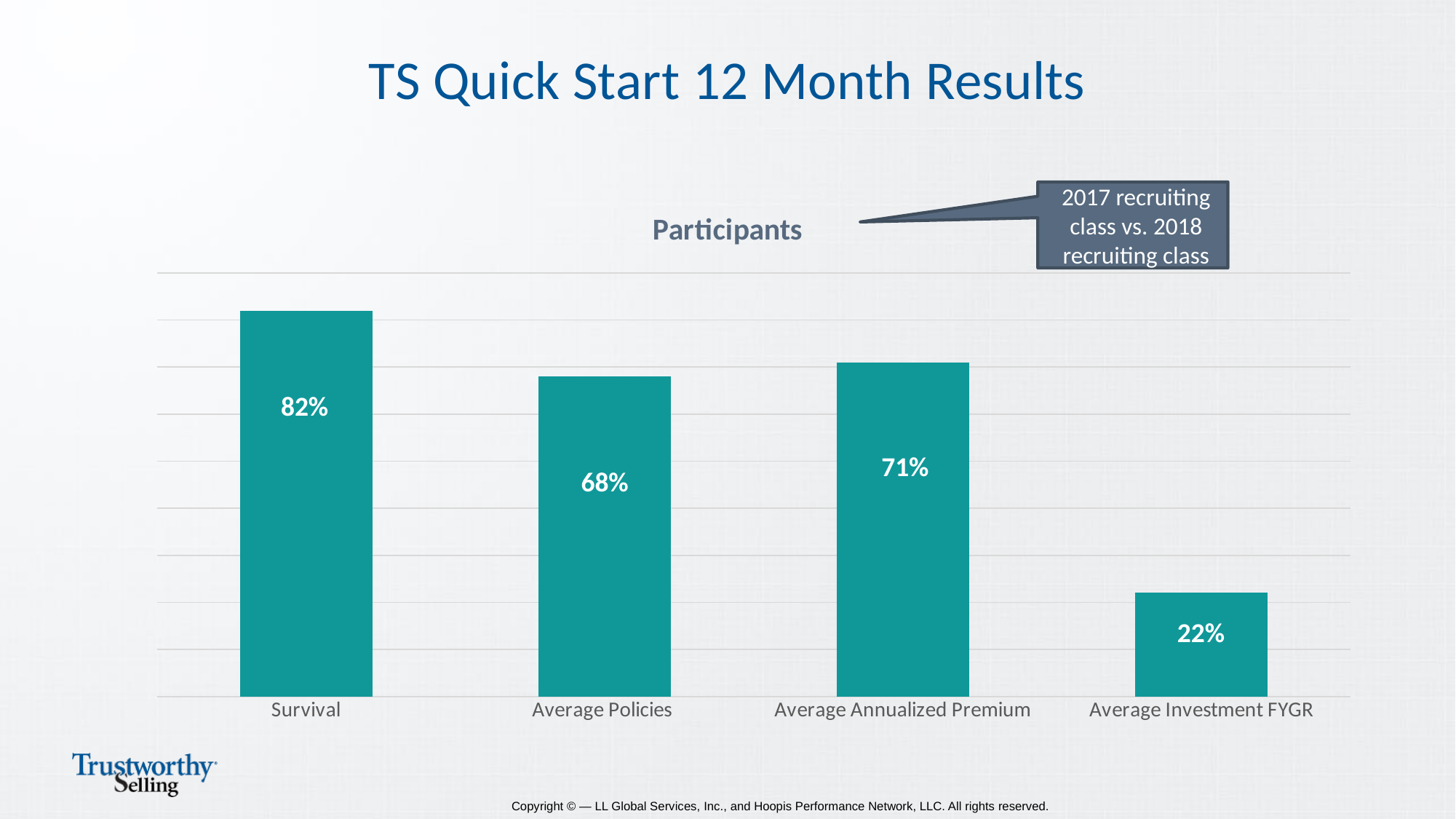
Which is larger, the value for Average Policies or the value for Average Annualized Premium? Average Annualized Premium What is the difference between the values for Average Annualized Premium and Average Policies? 3% Which category has the highest value? Survival What is the title of the chart? Participants What kind of chart is shown on the slide? Bar chart What is the value for Survival? 82% What is the value for Average Policies? 68% What is the value for Average Annualized Premium? 71% How many categories are shown in the chart? 4 What is the value for Average Investment FYGR? 22% What is the difference between the values for Survival and Average Investment FYGR? 60% Which category has the lowest value? Average Investment FYGR